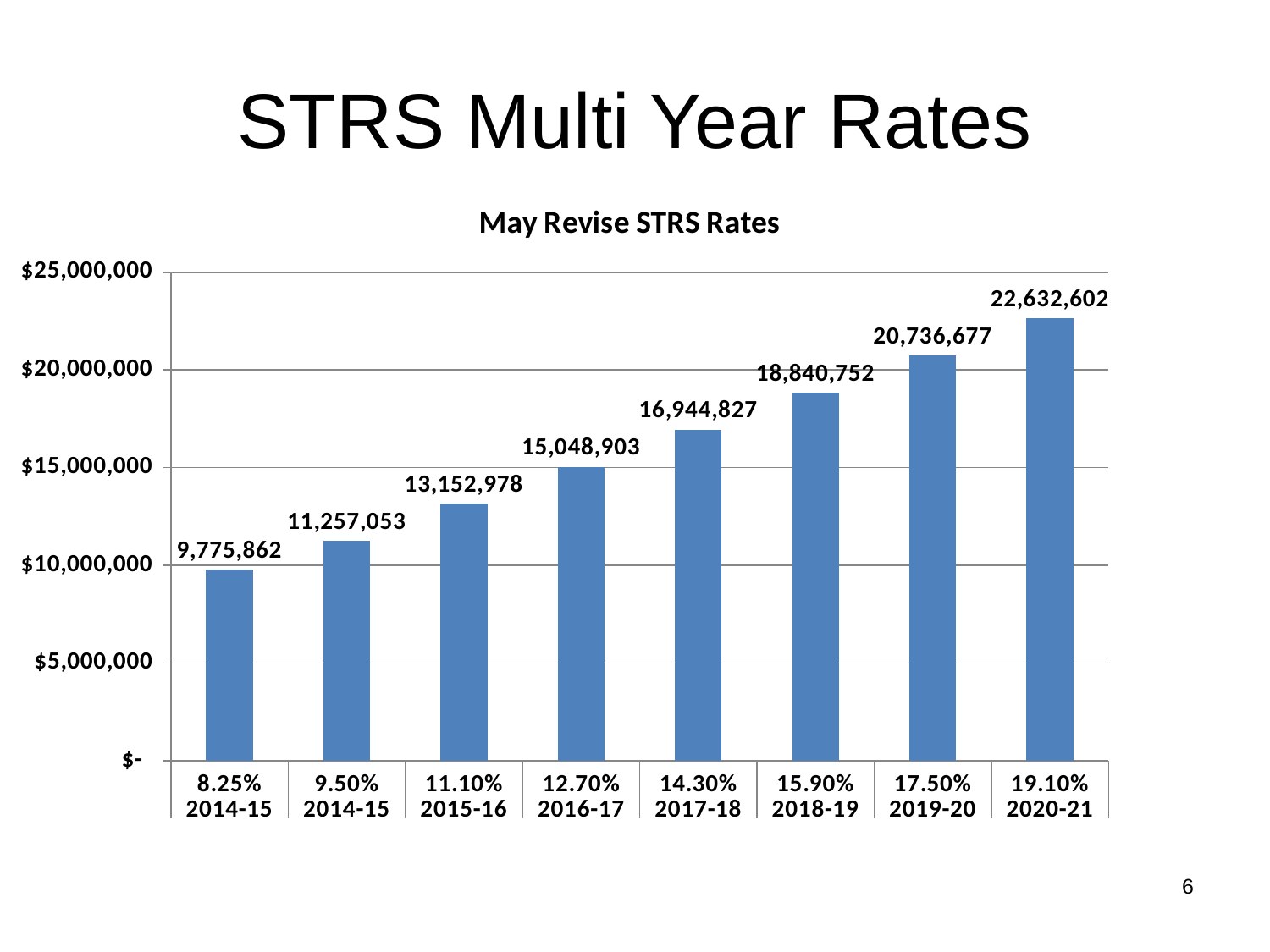
Do the values rise or fall from left to right along the x axis? rise Which is larger, the value for 12.70% 2016-17 or the value for 14.30% 2017-18? 14.30% 2017-18 Which category has the highest value? 19.10% 2020-21 What is the difference between the values for 17.50% 2019-20 and 15.90% 2018-19? 1,895,925 What is the value for 17.50% 2019-20? 20,736,677 What kind of chart is shown on the slide? bar chart What is the value for 11.10% 2015-16? 13,152,978 How many bars are shown in the chart? 8 Is the value for 15.90% 2018-19 greater or less than $20,000,000? less What is the value for the 9.50% 2014-15 bar? 11,257,053 What is the difference between the values for 19.10% 2020-21 and 8.25% 2014-15? 12,856,740 Which category has the lowest value? 8.25% 2014-15